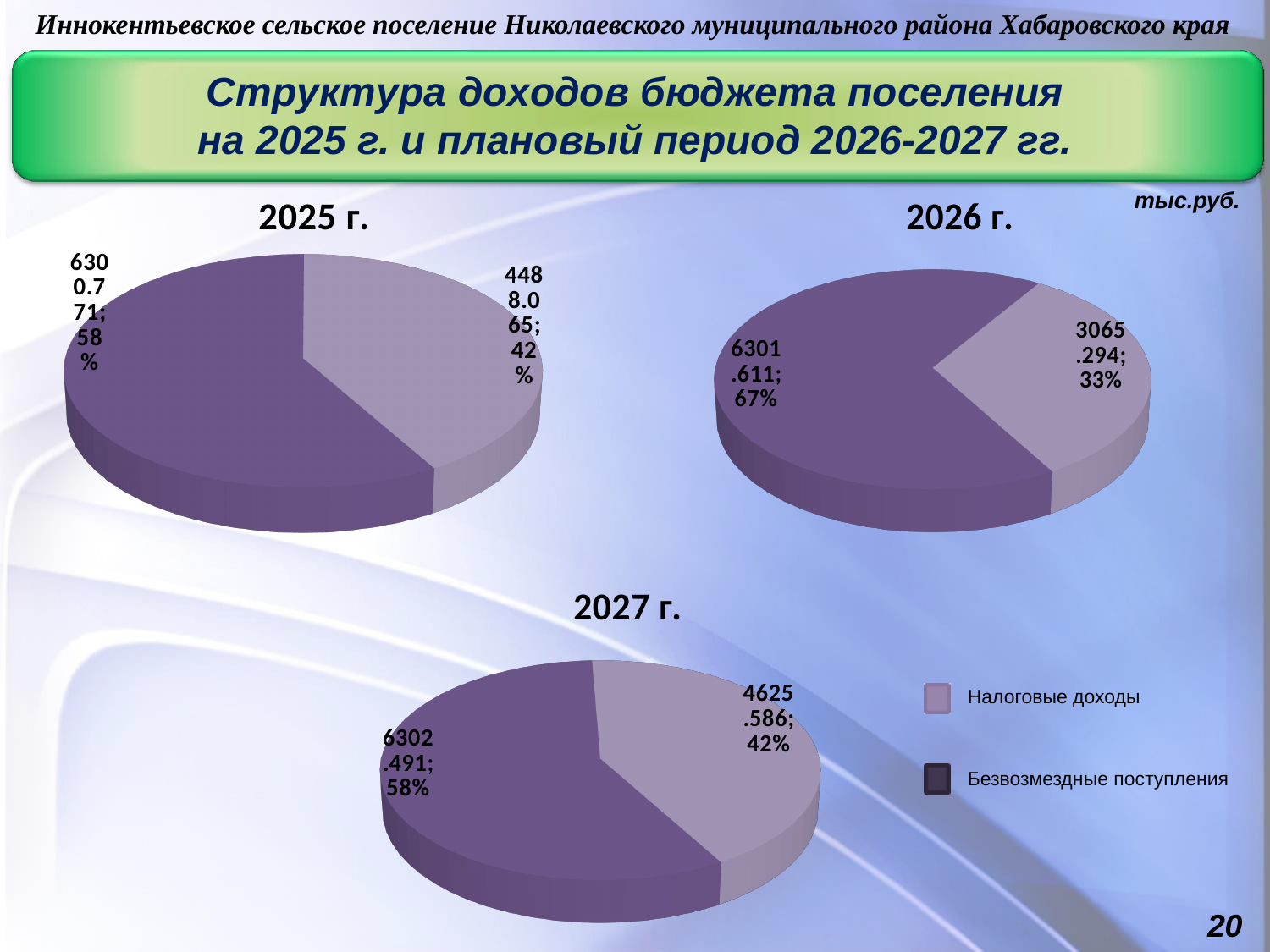
In the 2027 г. chart, which category is the smallest? Налоговые доходы In the 2027 г. chart, what is the value for Безвозмездные поступления? 6302.491 What type of charts are shown on the slide? Pie charts In the 2026 г. chart, which category is the largest? Безвозмездные поступления In the 2027 г. chart, what is the difference between Безвозмездные поступления and Налоговые доходы? 1676.905 In the 2025 г. chart, what share of the pie is Безвозмездные поступления? 58% Which legend entry is shown in the darker purple colour? Безвозмездные поступления In the 2027 г. chart, what share of the pie is Налоговые доходы? 42% In the 2026 г. chart, what is the value for Налоговые доходы? 3065.294 How many pie charts are on the slide? 3 In the 2026 г. chart, what share of the pie is Безвозмездные поступления? 67% How many entries does the legend list? 2